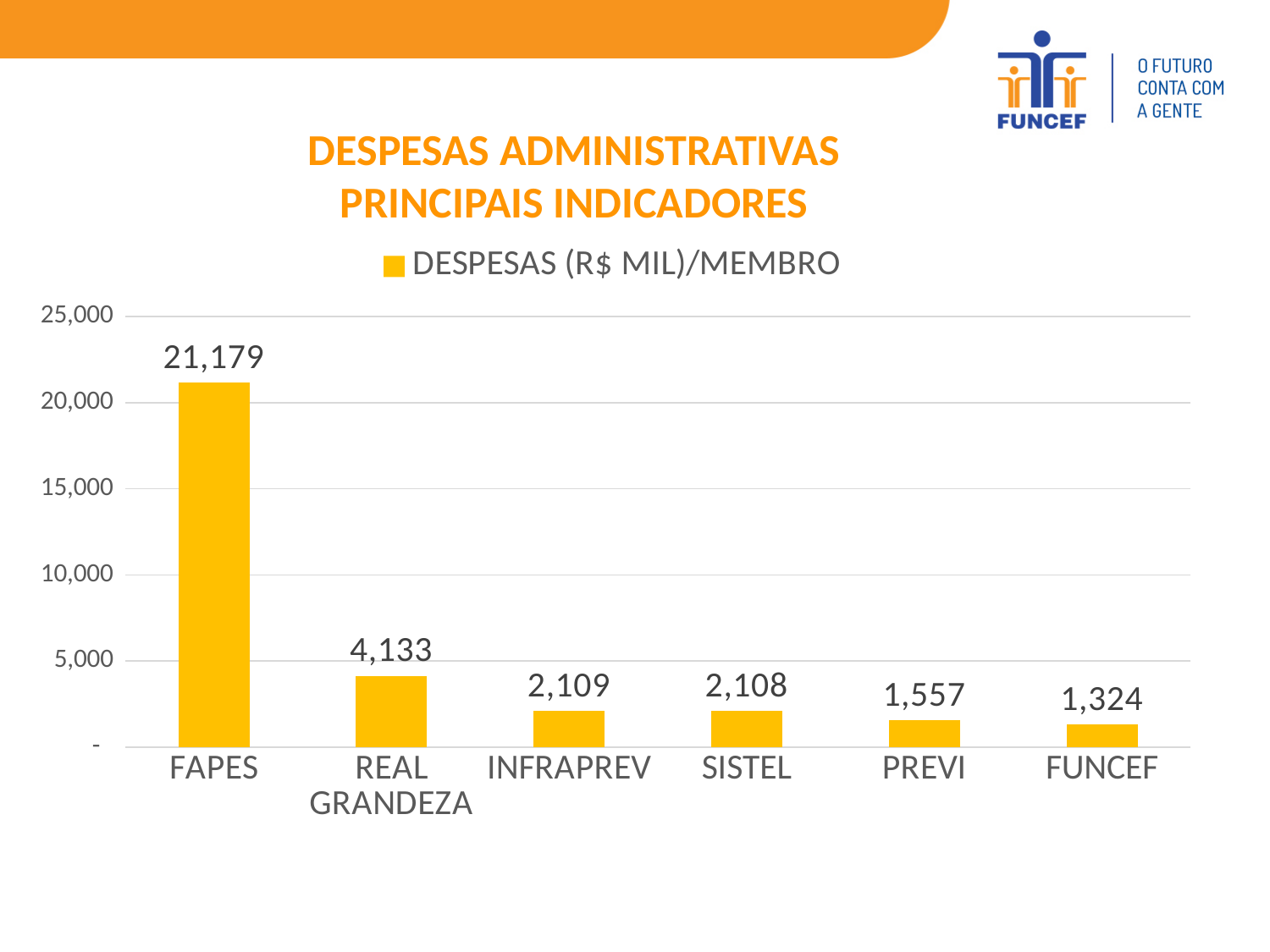
What is the value for PREVI? 1,557 What is the difference between the values for FAPES and REAL GRANDEZA? 17,046 What is the value for FAPES? 21,179 How many categories are shown on the x axis? 6 What is the difference between the values for PREVI and FUNCEF? 233 Which is larger, the value for REAL GRANDEZA or the value for INFRAPREV? REAL GRANDEZA What series name does the legend show? DESPESAS (R$ MIL)/MEMBRO What is the value for REAL GRANDEZA? 4,133 Which category has the lowest value? FUNCEF What is the value for FUNCEF? 1,324 What kind of chart is shown on the slide? Bar chart Which category has the highest value? FAPES